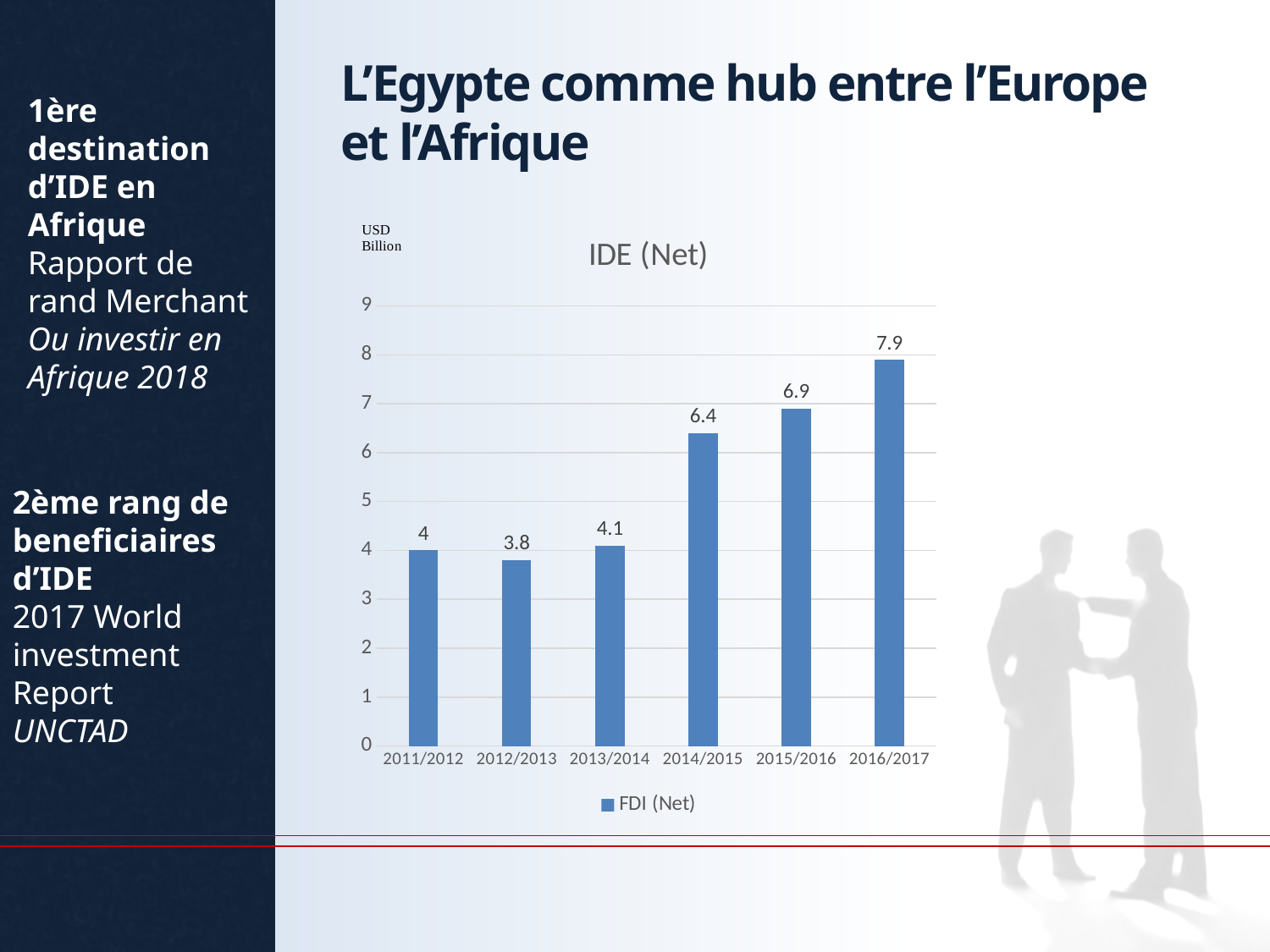
What is the value for 2016/2017? 7.9 Which is larger, the value for 2013/2014 or the value for 2015/2016? 2015/2016 How many years are shown on the x axis? 6 Which year has the highest value? 2016/2017 What is the title of the chart? IDE (Net) How many series does the legend list? 1 Which year has the lowest value? 2012/2013 Is the value for 2014/2015 greater or less than 6? greater What kind of chart is shown? bar chart What is the value for 2014/2015? 6.4 What is the difference between the values for 2016/2017 and 2011/2012? 3.9 What is the value for 2012/2013? 3.8